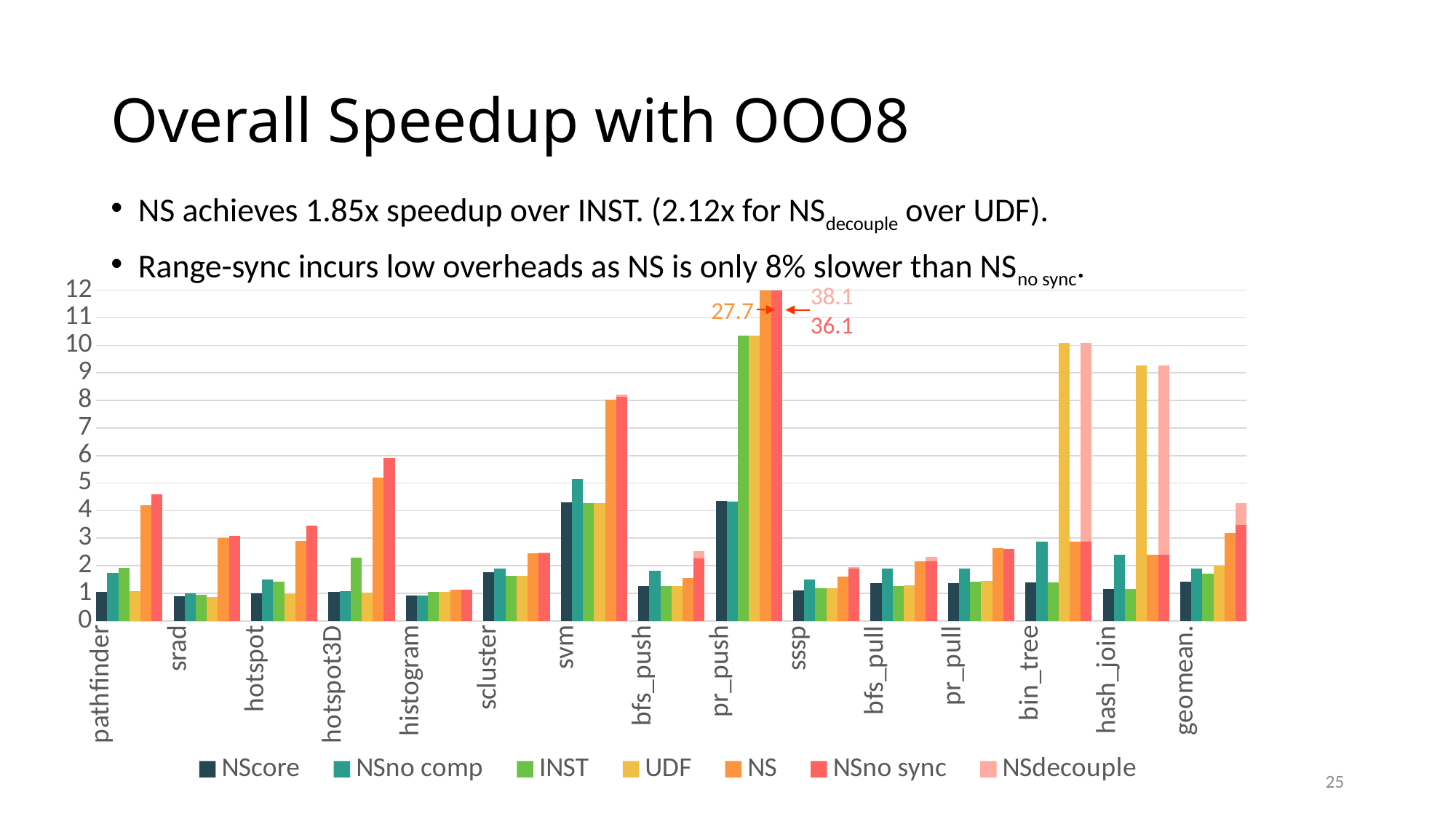
Is the NS value for svm greater or less than 7? greater What is the NSdecouple value for pr_push? 38.1 What is the last entry listed in the chart's legend? NSdecouple For pr_push, which is larger: the NSdecouple value or the NSno sync value? NSdecouple What is the NS value for pr_push? 27.7 How many categories are shown along the x axis of the chart? 15 What is the difference between the NSdecouple value and the NSno sync value for pr_push? 2.0 What kind of chart is shown on the slide? bar chart What is the NSno sync value for pr_push? 36.1 Which category has the highest NS value? pr_push Is the NSno sync value for hotspot3D greater or less than 5? greater How many series does the chart's legend list? 7